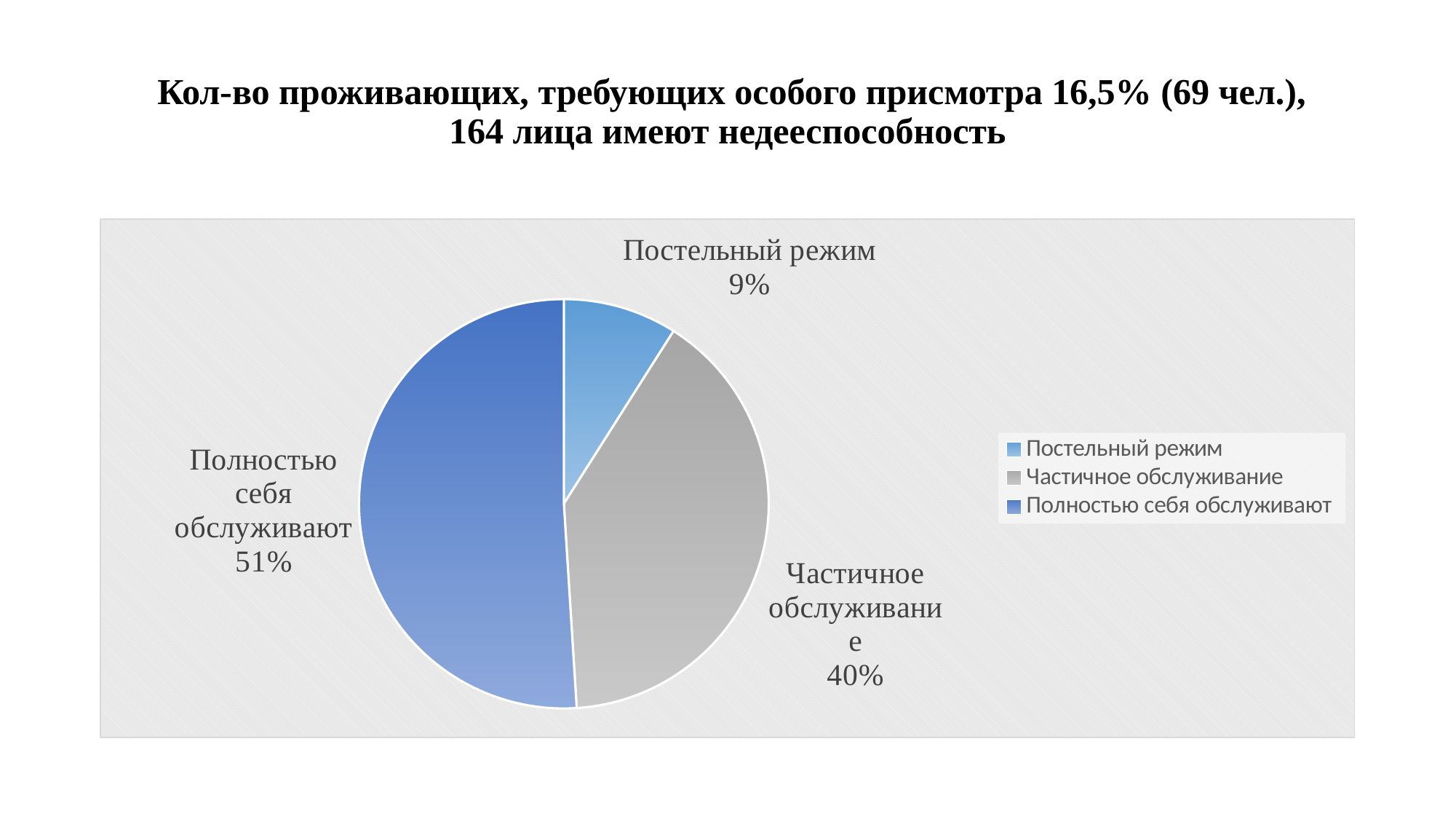
Which is larger: the slice for "Частичное обслуживание" or the slice for "Постельный режим"? Частичное обслуживание How many entries does the legend list? 3 What share of the pie does "Постельный режим" represent? 9% Which category has the smallest slice of the pie? Постельный режим What share of the pie does "Частичное обслуживание" represent? 40% What is the difference in percentage points between "Полностью себя обслуживают" and "Частичное обслуживание"? 11 What is the difference in percentage points between "Частичное обслуживание" and "Постельный режим"? 31 What colour is the slice for "Частичное обслуживание"? grey What share of the pie does "Полностью себя обслуживают" represent? 51% What kind of chart is shown on the slide? pie chart How many slices does the pie chart have? 3 Which category has the largest slice of the pie? Полностью себя обслуживают